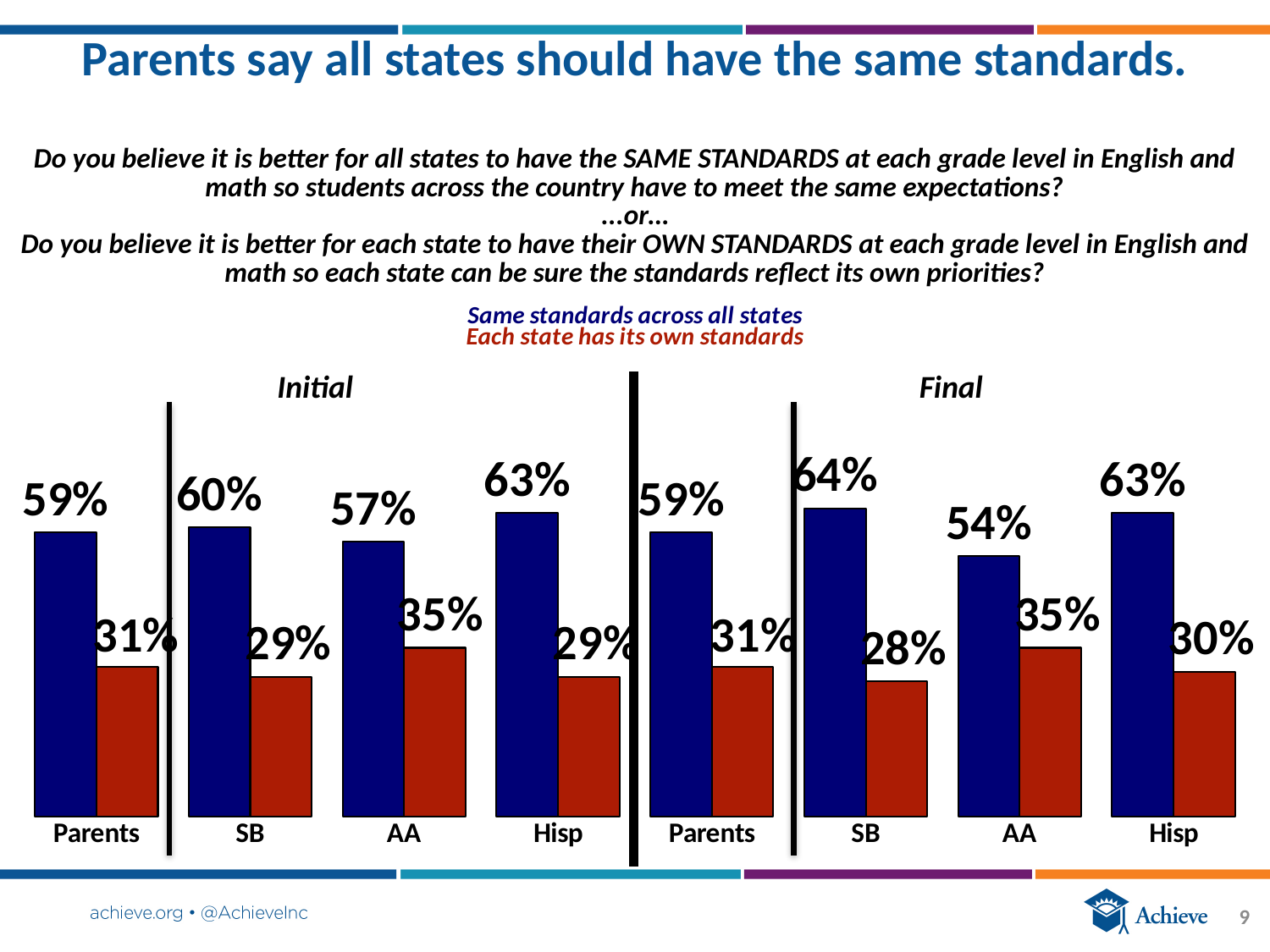
In the Final section, what percentage of SB respondents said each state should have its own standards? 28% How many groups are shown in the Initial section of the chart? 4 In the Initial section, what percentage of Parents said all states should have the same standards? 59% In the Final section, what is the value for AA for 'Same standards across all states'? 54% How many series does the legend list? 2 Which is larger: the Initial SB value for 'Same standards across all states' or the Final SB value for the same series? Final SB (64%) In the Initial section, which group has the highest percentage for 'Same standards across all states'? Hisp What is the difference between the Initial and Final AA values for 'Same standards across all states'? 3 percentage points What kind of chart is shown on the slide? Bar chart In the Final section, which group has the lowest percentage for 'Same standards across all states'? AA In the Final section, what is the difference between the SB values for 'Same standards across all states' and 'Each state has its own standards'? 36 percentage points What colour represents 'Each state has its own standards'? Red